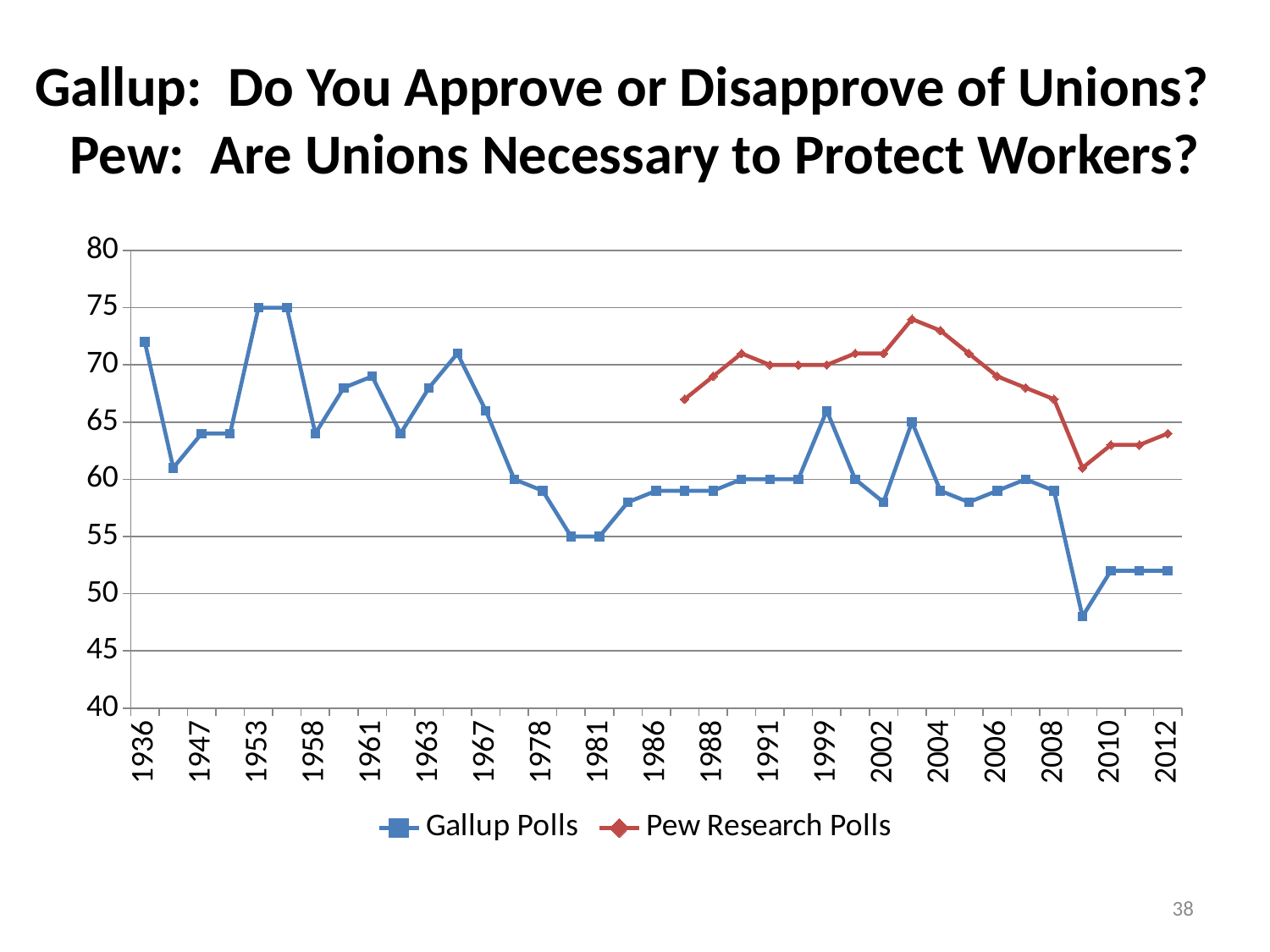
Which series has the higher value in 2008, Gallup Polls or Pew Research Polls? Pew Research Polls What is the Gallup Polls value for 1981? 55 What is the Gallup Polls value for 1953? 75 Is the Gallup Polls value for 1936 greater or less than 70? greater What colour is the Pew Research Polls line? red Does the Pew Research Polls line rise or fall between 2004 and 2008? fall What is the Pew Research Polls value for 1991? 70 What is the Gallup Polls value for 1991? 60 What kind of chart is shown on the slide? line chart How many series does the legend list? 2 Is the Pew Research Polls value for 2004 greater or less than 70? greater Is the Gallup Polls value for 2012 greater or less than 55? less